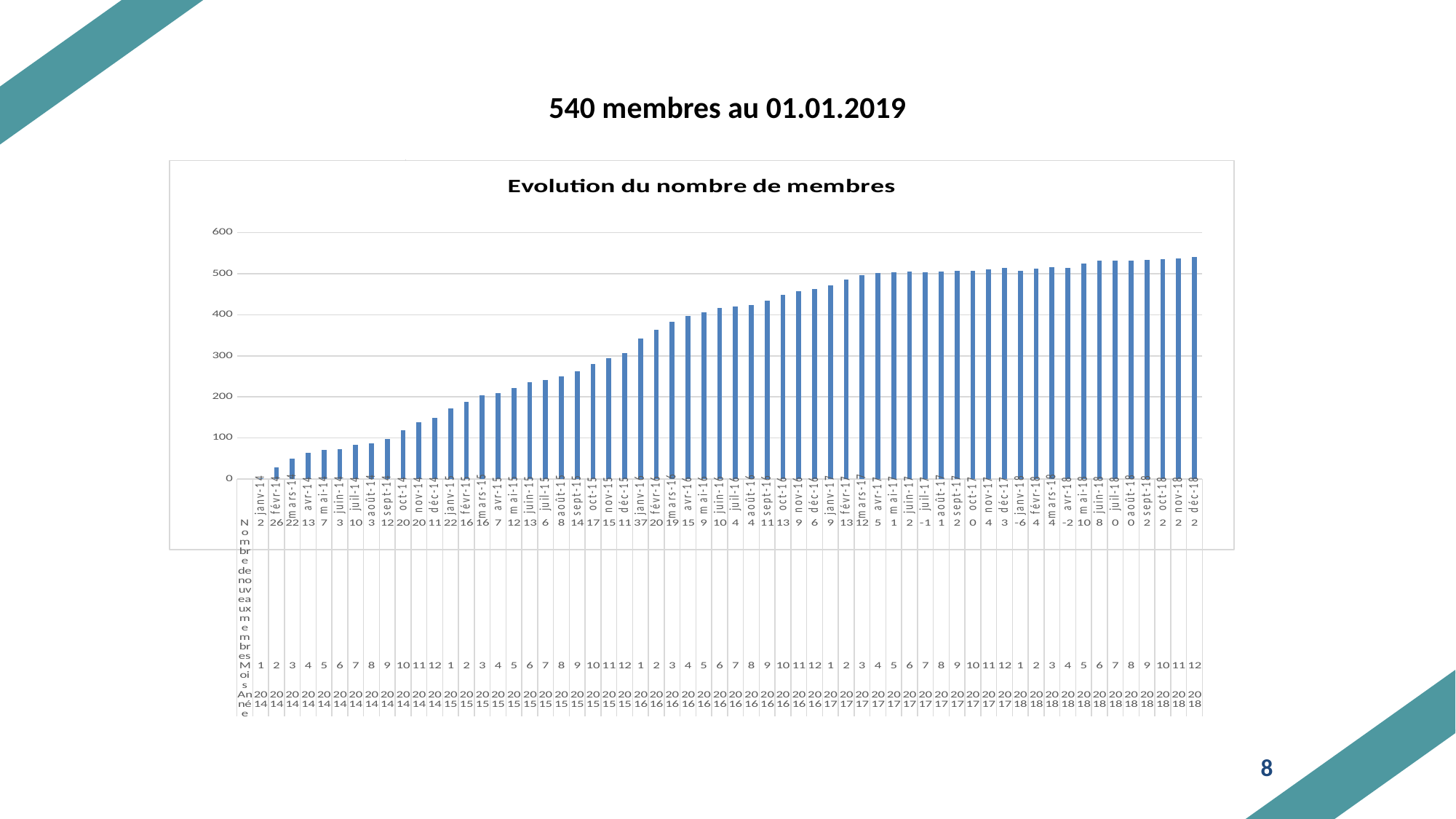
Which month has the lowest bar in the chart? janv-14 According to the data table, how many new members (Nombre de nouveaux membres) were added in janv-16? 37 Is the value for janv-15 greater or less than 200? less How many monthly bars are plotted in the chart? 60 Do the bar values rise or fall from janv-14 to déc-18? rise What kind of chart is shown on the slide? bar chart Is the value for déc-16 greater or less than 500? less Which bar is taller, juil-15 or juil-16? juil-16 Is the value for janv-16 greater or less than 300? greater What is the title of the chart? Evolution du nombre de membres Which month has the highest bar in the chart? déc-18